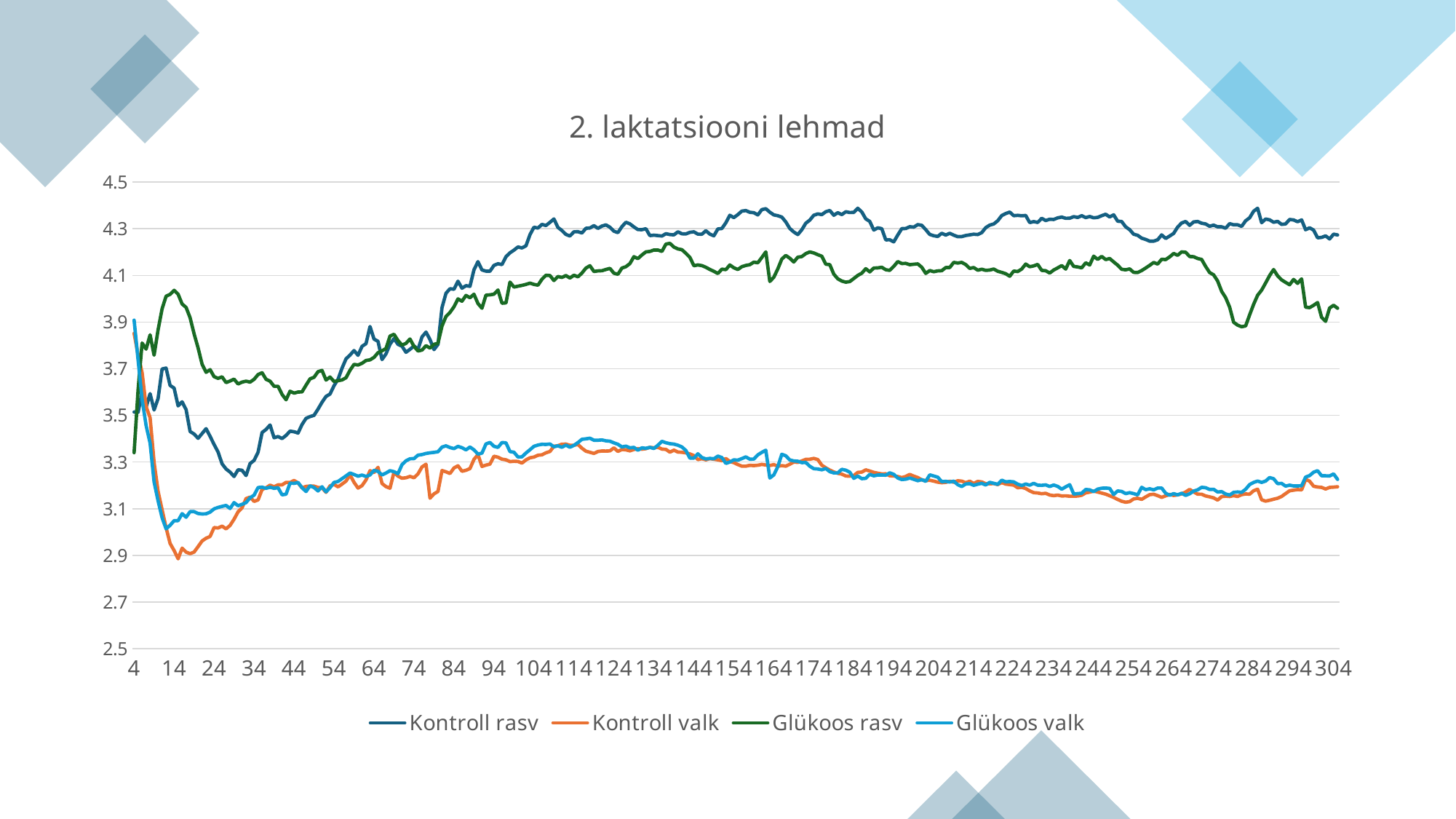
Is the value for Glükoos rasv at x = 284 greater or less than 4.1? less Does the Kontroll rasv line rise or fall between x = 34 and x = 104? rise What kind of chart is shown on the slide? line chart At x = 14, which series has the higher value: Glükoos rasv or Kontroll rasv? Glükoos rasv At x = 204, which series has the higher value: Kontroll rasv or Glükoos rasv? Kontroll rasv How many series does the legend list? 4 Is the value for Kontroll valk at x = 14 greater or less than 3.1? less Which series has the lowest value at x = 14? Kontroll valk Is the value for Glükoos valk at x = 114 greater or less than 3.3? greater What is the title of the chart? 2. laktatsiooni lehmad Which colour is used for the Kontroll valk series in the legend? orange